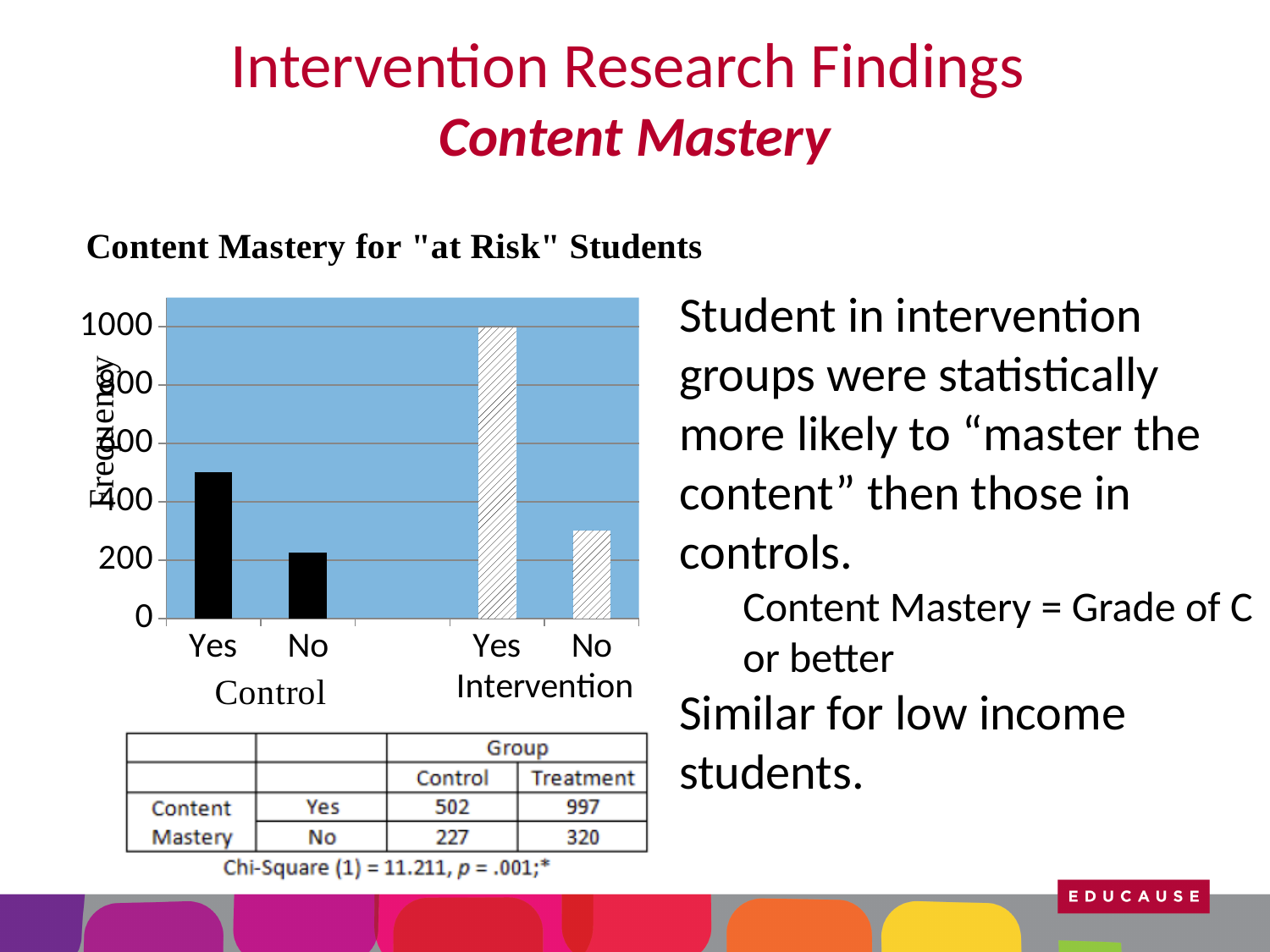
Which bar is the tallest in the chart? Intervention Yes Is the value for Control Yes greater or less than 600? less Is the value for Intervention No greater or less than 400? less According to the table below the chart, what is the Treatment Yes frequency? 997 What type of chart is shown under the title "Content Mastery for "at Risk" Students"? bar chart Which bar is the shortest in the chart? Control No Is the value for Control No greater or less than 200? greater How many bars are plotted in the chart? 4 Which is larger, the Control Yes bar or the Intervention No bar? Control Yes What is the title of the chart? Content Mastery for "at Risk" Students According to the table below the chart, what is the Control Yes frequency? 502